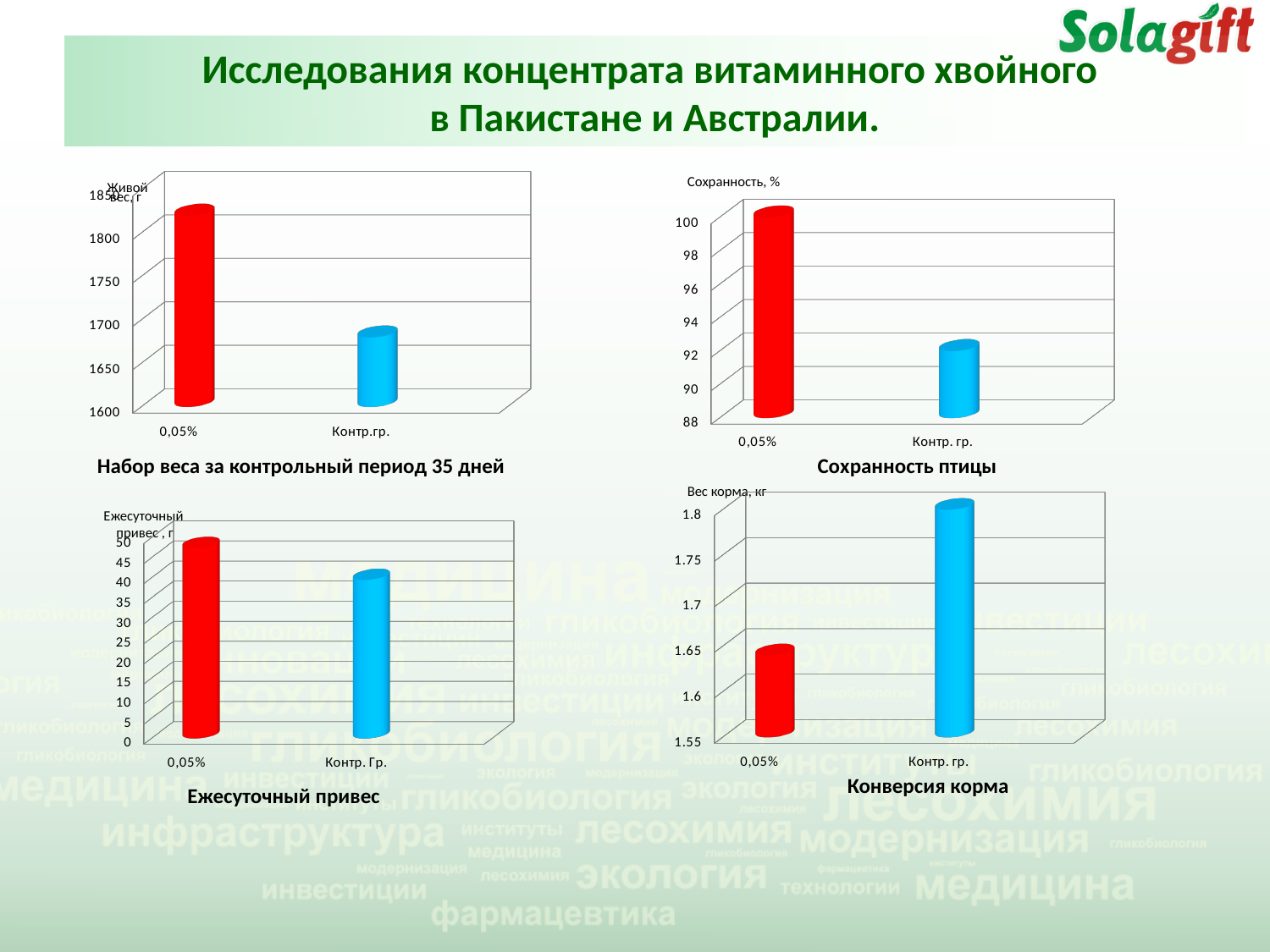
On the chart titled 'Ежесуточный привес', is the value for 0,05% greater or less than 45? greater On the chart titled 'Сохранность птицы', which category has the lowest value? Контр. гр. On the chart titled 'Сохранность птицы', is the value for Контр. гр. greater or less than 94? less On the chart titled 'Набор веса за контрольный период 35 дней', which category has the higher value? 0,05% What kind of chart is the one titled 'Ежесуточный привес'? bar chart On the chart titled 'Конверсия корма', is the value for 0,05% greater or less than 1.7? less On the chart titled 'Конверсия корма', which category has the higher value, 0,05% or Контр. гр.? Контр. гр. How many categories are shown on the chart titled 'Конверсия корма'? 2